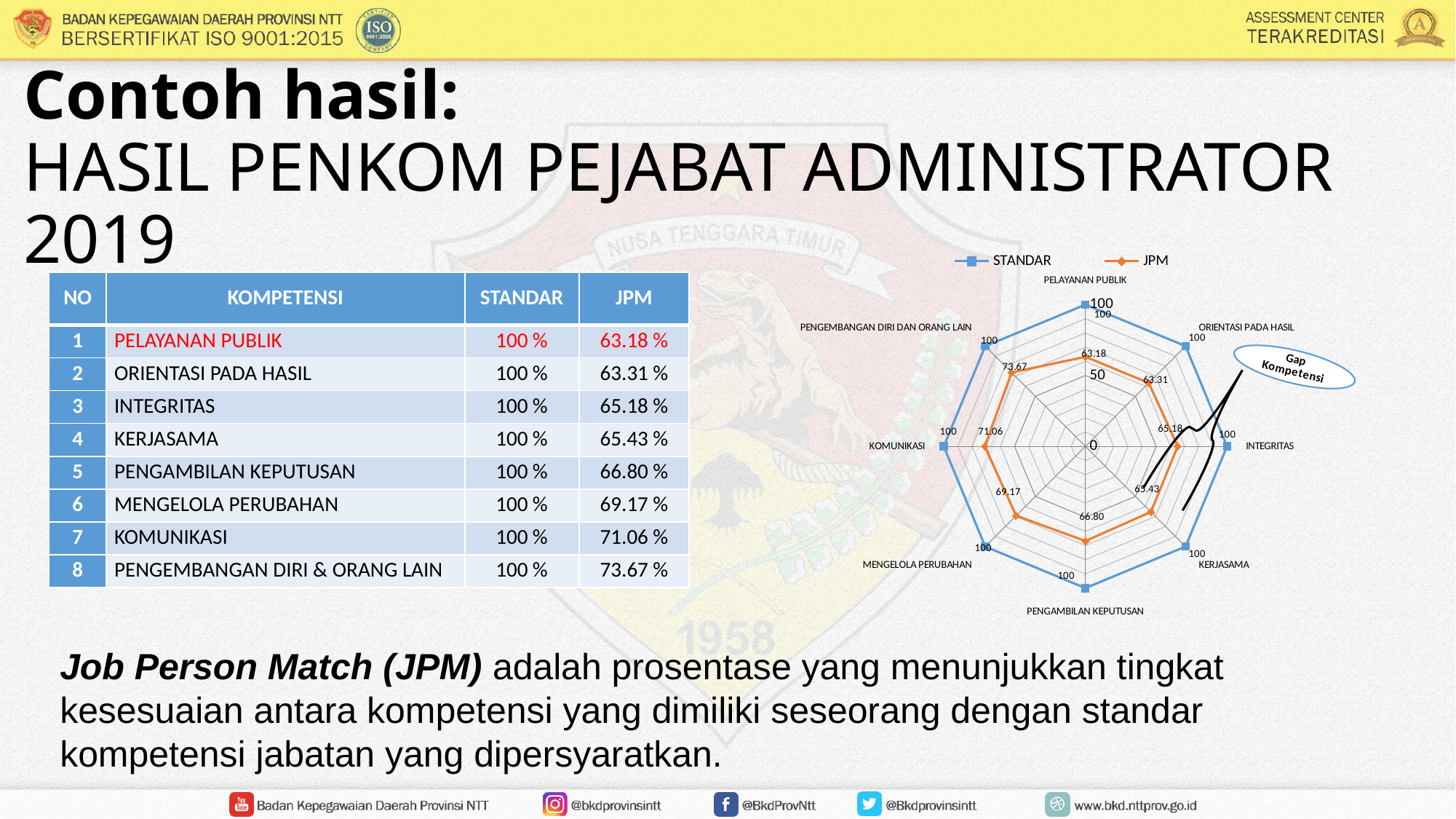
What is the JPM value for PELAYANAN PUBLIK on the chart? 63.18 What are the two series named in the chart legend? STANDAR and JPM How many series does the chart legend list? 2 What is the JPM value for PENGEMBANGAN DIRI DAN ORANG LAIN on the chart? 73.67 Which category has the highest JPM value on the chart? PENGEMBANGAN DIRI DAN ORANG LAIN What kind of chart is shown on the slide? Radar chart What is the difference between the STANDAR value and the JPM value for PENGAMBILAN KEPUTUSAN on the chart? 33.20 How many competency categories are plotted on the radar chart? 8 Which is larger on the chart, the JPM value for MENGELOLA PERUBAHAN or the JPM value for KERJASAMA? MENGELOLA PERUBAHAN Which category has the lowest JPM value on the chart? PELAYANAN PUBLIK What is the JPM value for KOMUNIKASI on the chart? 71.06 What is the STANDAR value for INTEGRITAS on the chart? 100